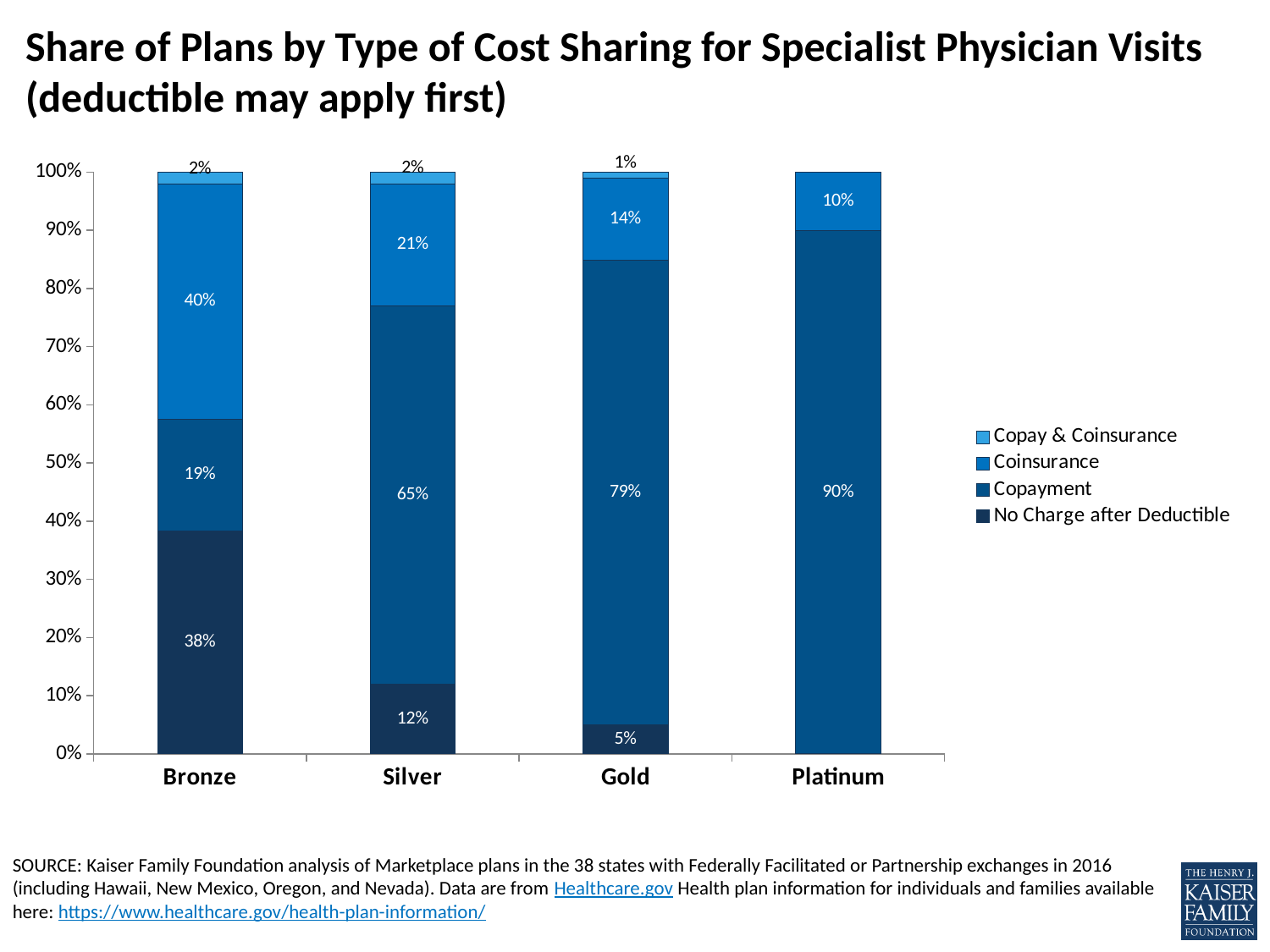
What is the difference between the copayment share for Gold plans and for Silver plans? 14% What share of Silver plans have no charge after deductible for specialist physician visits? 12% How many series does the legend list? 4 Which metal level has the highest share of plans with no charge after deductible? Bronze How many metal levels are shown on the x axis? 4 What share of Bronze plans have a copayment for specialist physician visits? 19% What share of Gold plans use coinsurance for specialist physician visits? 14% Does the share of plans with a copayment rise or fall from Bronze to Platinum? Rise What share of Platinum plans have a copayment for specialist physician visits? 90% Which metal level has the lowest share of plans with a copayment? Bronze What kind of chart is shown on the slide? Stacked bar chart Which is larger for Bronze plans: the share with coinsurance or the share with no charge after deductible? Coinsurance